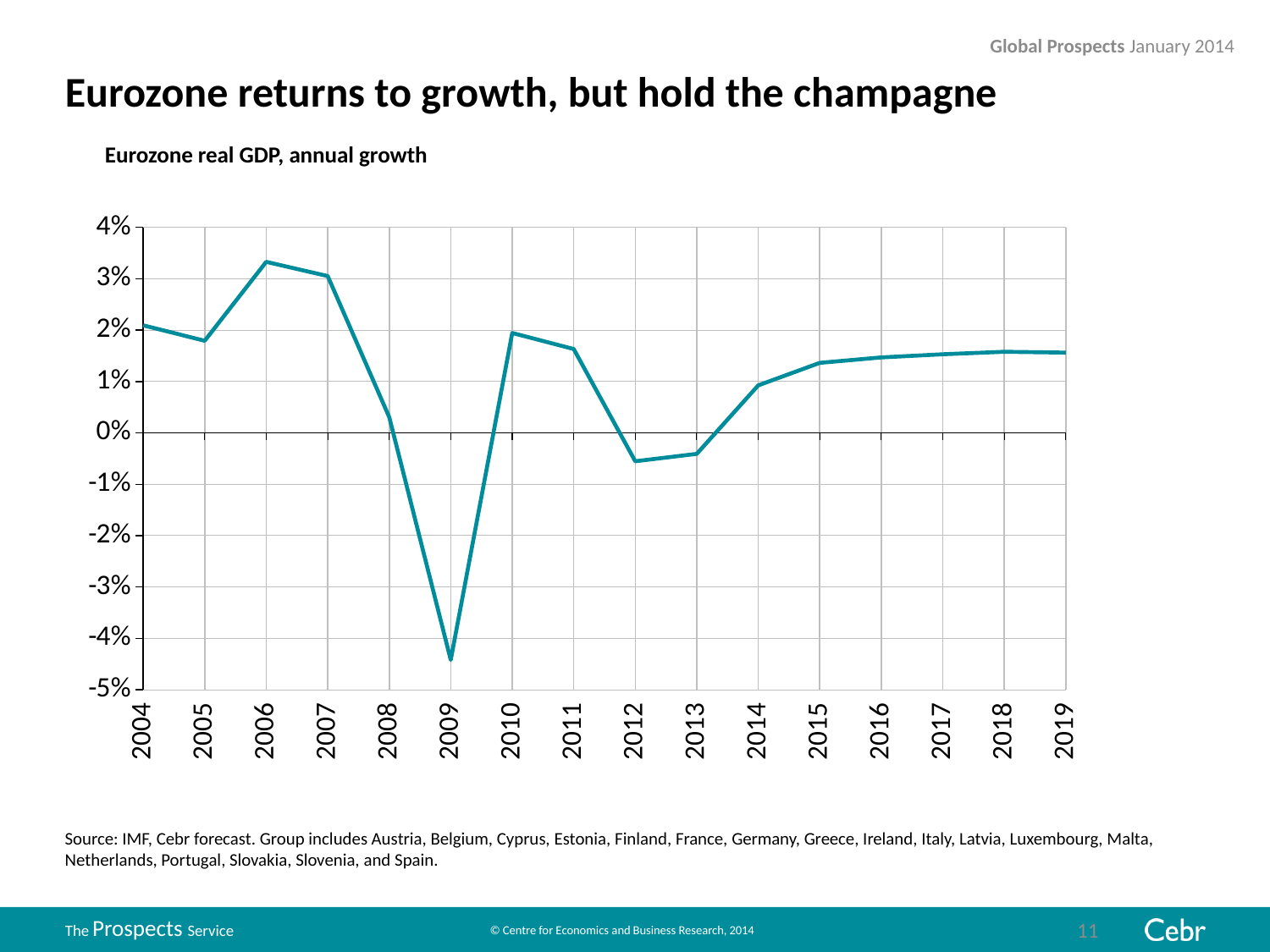
Which year has the larger GDP growth value, 2006 or 2010? 2006 Is the value for 2019 greater or less than 1%? greater What is the title of the chart? Eurozone real GDP, annual growth Is the value for 2009 greater or less than -4%? less How many years are shown on the x axis of the chart? 16 Is the value for 2006 greater or less than 3%? greater Which year has the highest Eurozone real GDP growth in the chart? 2006 Which year has the larger GDP growth value, 2012 or 2014? 2014 Do the values rise or fall from 2013 to 2019? rise Which year has the lowest Eurozone real GDP growth in the chart? 2009 What kind of chart is shown on the slide? line chart